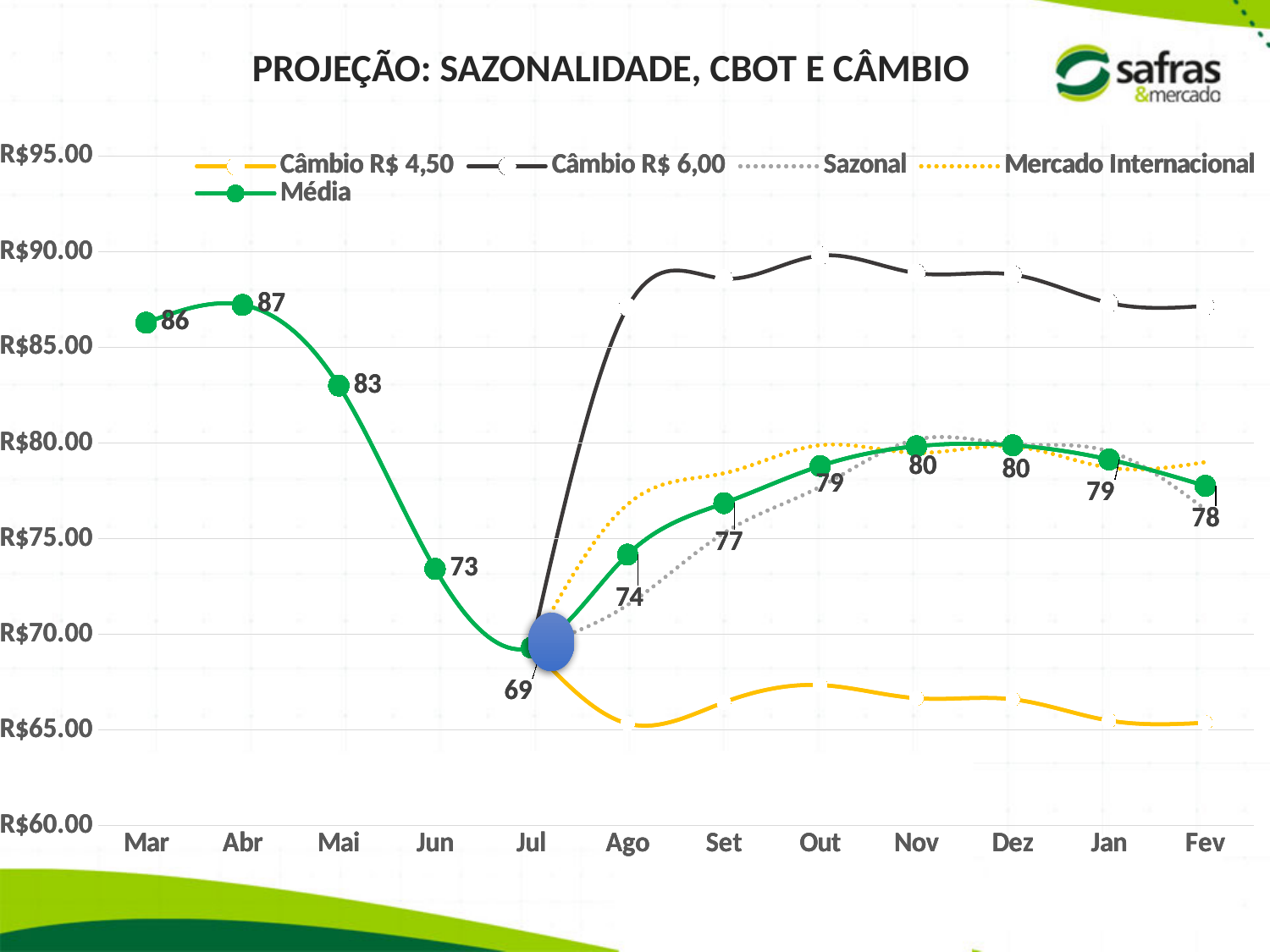
What is the title of the chart? PROJEÇÃO: SAZONALIDADE, CBOT E CÂMBIO Is the Média value in Mai larger or smaller than in Set? larger In which month is the Média series highest? Abr What is the value of the Média series in Fev? 78 What is the value of the Média series in Abr? 87 In which month is the Média series lowest? Jul How many months are shown on the x axis? 12 What is the difference between the Média values in Abr and Jul? 18 How many series does the legend list? 5 Is the value of the Câmbio R$ 6,00 series in Out greater or less than R$85.00? greater What kind of chart is shown on the slide? line chart What is the value of the Média series in Jul? 69